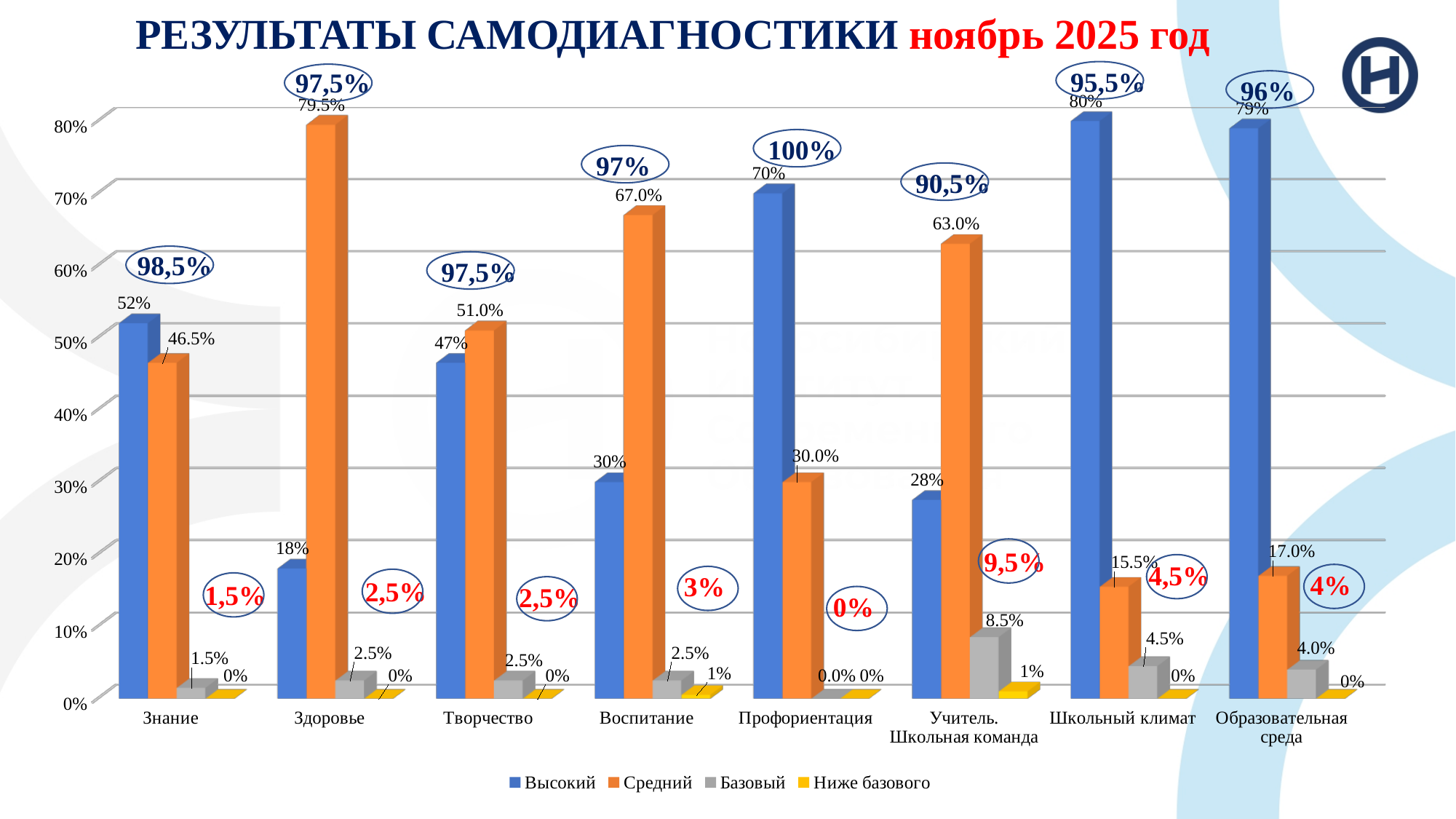
Which category has the lowest value in the Высокий series? Здоровье What is the combined total of the Высокий and Средний values for Профориентация? 100% How many categories are shown on the x axis? 8 What kind of chart is shown on the slide? bar chart Is the Средний value for Воспитание greater or less than 60%? greater For Творчество, which is larger: the Высокий value or the Средний value? Средний Which category has the highest value in the Средний series? Здоровье What is the value of the Высокий series for Школьный климат? 80% What is the value of the Средний series for Здоровье? 79.5% What is the difference between the Высокий and Средний values for Знание? 5.5% What is the value of the Базовый series for Учитель. Школьная команда? 8.5% How many series does the legend list? 4